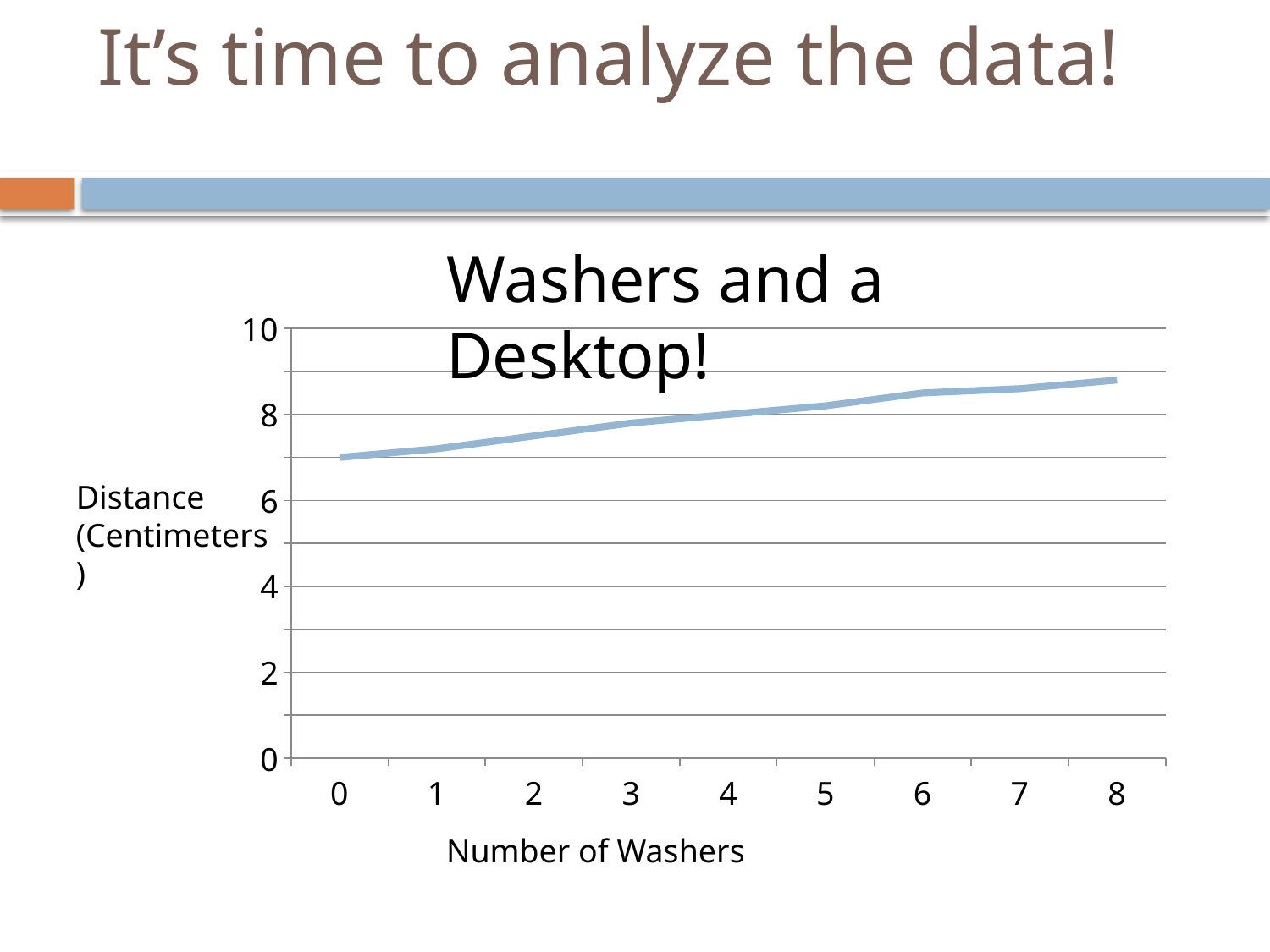
What is the label of the x axis? Number of Washers Which has the larger distance, 8 washers or 0 washers? 8 washers What kind of chart is shown on the slide? line chart At which number of washers is the distance lowest? 0 Is the distance for 4 washers greater or less than 6? greater At which number of washers is the distance highest? 8 What is the title of the chart? Washers and a Desktop! Does the distance rise or fall as the number of washers increases? rises Is the distance for 8 washers greater or less than 8? greater Is the distance for 2 washers greater or less than 8? less How many data points are plotted on the line? 9